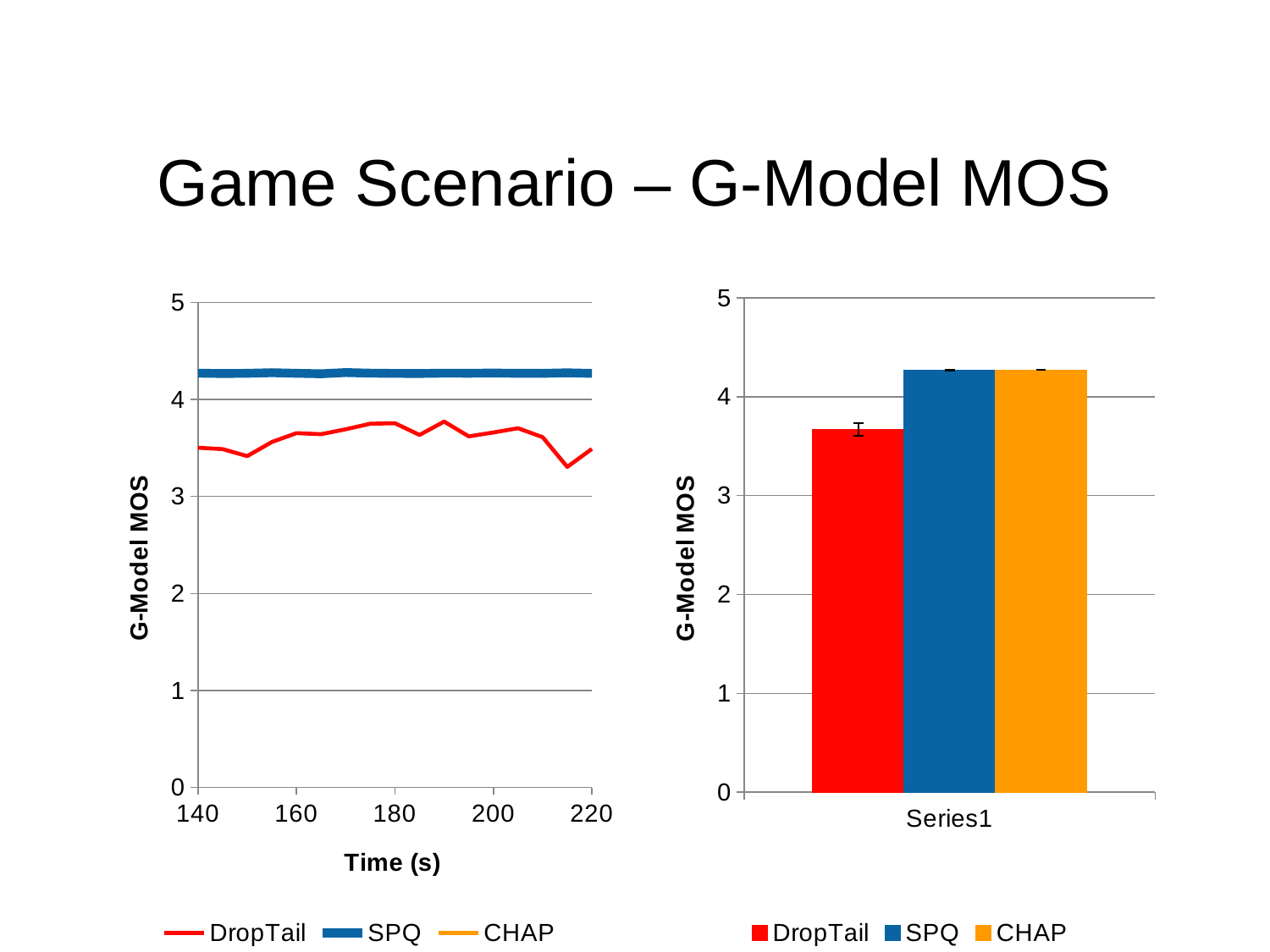
In the right chart, which series has the lowest bar? DropTail What kind of chart is the chart on the left of the slide? line chart In the right chart, how many series does the legend list? 3 In the right chart, is the value for SPQ greater or less than 4? greater In the right chart, is the value for DropTail greater or less than 4? less What is the x-axis label of the left chart? Time (s) In the left chart, is the SPQ line above or below 4 across the whole time range? above What category label is shown on the x axis of the right chart? Series1 In the left chart, how many series does the legend list? 3 What kind of chart is the chart on the right of the slide? bar chart In the right chart, which is larger, the DropTail bar or the SPQ bar? SPQ